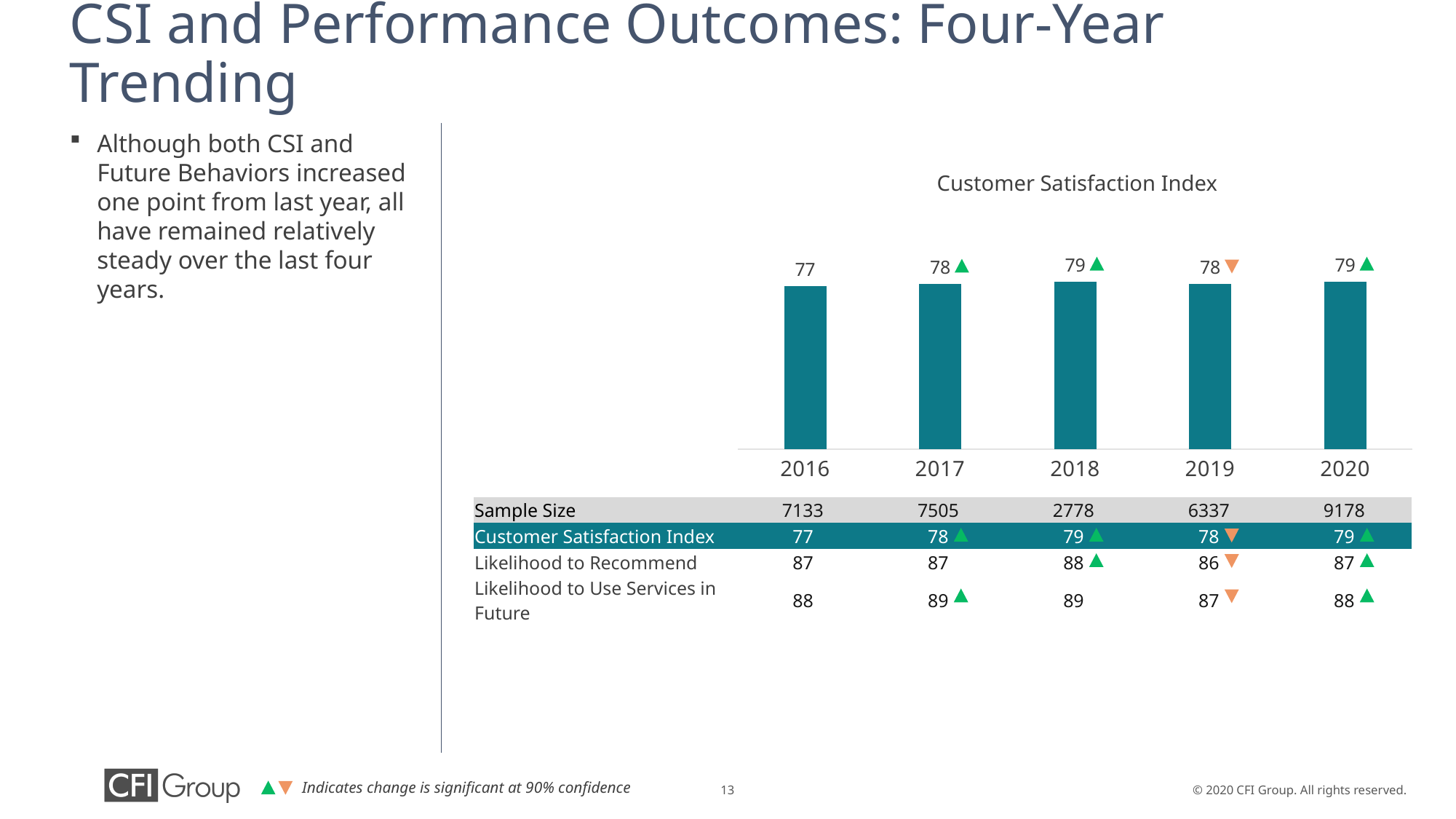
What kind of chart is the Customer Satisfaction Index chart? bar chart Did the Customer Satisfaction Index rise or fall from 2016 to 2017? rise What is the Customer Satisfaction Index value for 2019? 78 What colour are the bars in the Customer Satisfaction Index chart? teal What is the difference between the Customer Satisfaction Index values for 2018 and 2016? 2 What is the Customer Satisfaction Index value for 2016? 77 Did the Customer Satisfaction Index rise or fall from 2018 to 2019? fall Is the Customer Satisfaction Index value for 2019 larger or smaller than the value for 2020? smaller How many years are shown on the x axis of the Customer Satisfaction Index chart? 5 What is the Customer Satisfaction Index value for 2020? 79 What is the title of the chart on the slide? Customer Satisfaction Index Which year has the lowest Customer Satisfaction Index value? 2016